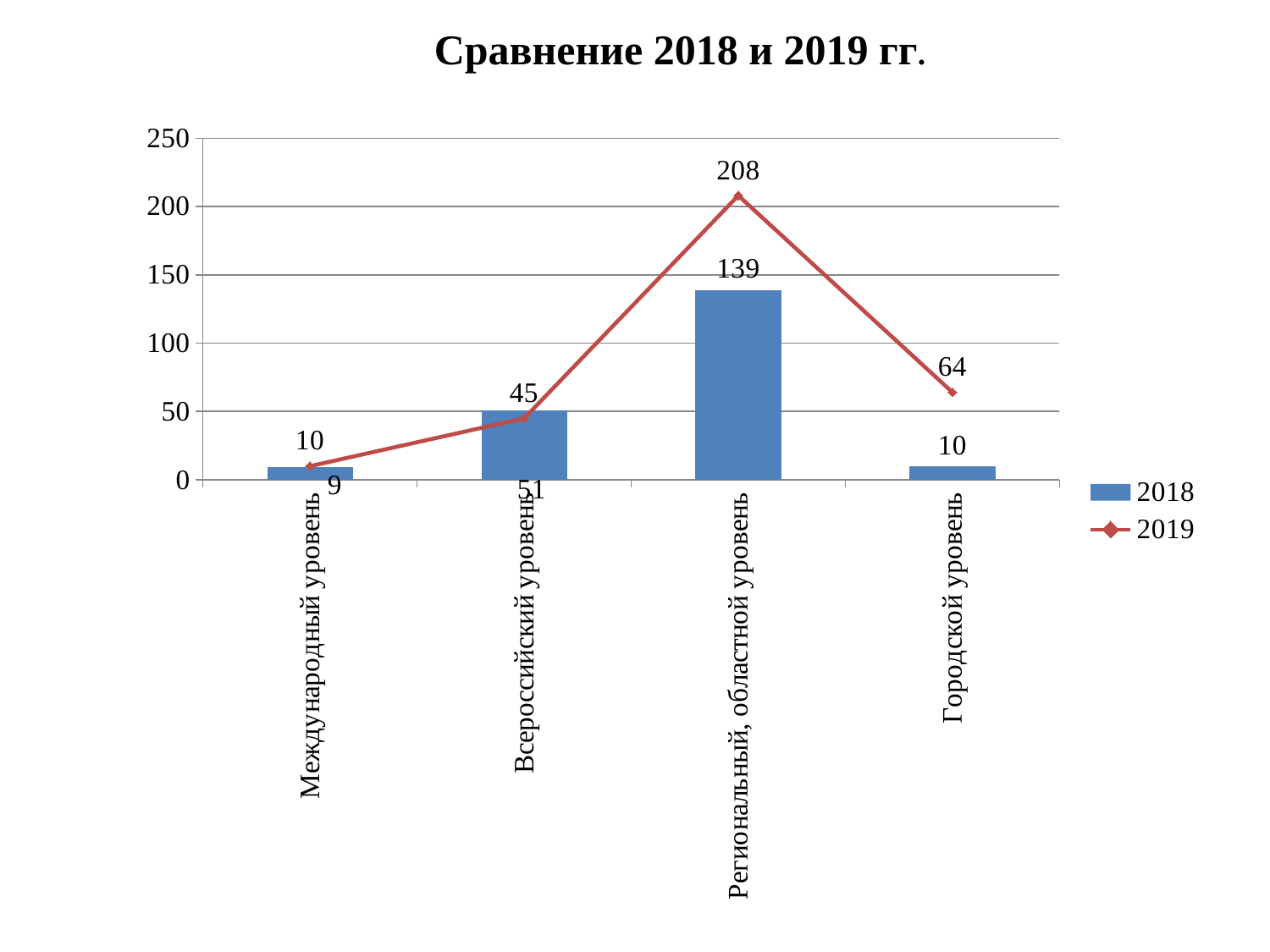
Which category has the highest 2019 value? Региональный, областной уровень How many categories are shown on the x axis? 4 How many series does the legend list? 2 What is the 2019 value for Городской уровень? 64 What is the difference between the 2019 and 2018 values for Региональный, областной уровень? 69 What kind of chart is shown on the slide? A combination bar and line chart Which category has the highest 2018 value? Региональный, областной уровень What is the 2018 value for Региональный, областной уровень? 139 Is the 2019 value for Всероссийский уровень greater or less than 100? less What is the 2018 value for Городской уровень? 10 For Городской уровень, which is larger: the 2018 value or the 2019 value? 2019 What is the 2019 value for Региональный, областной уровень? 208